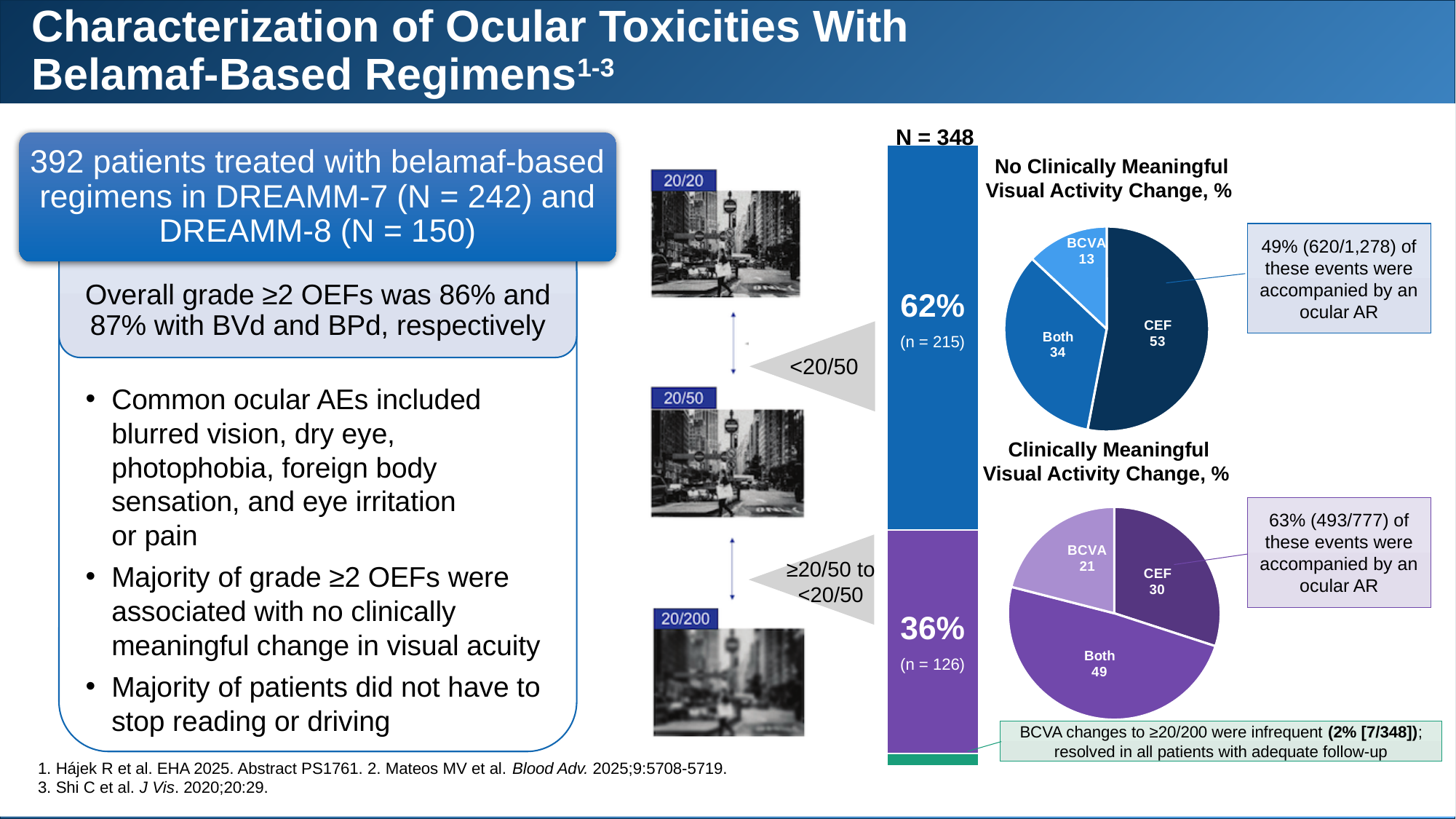
In the stacked bar on the slide, what percentage is shown for the top (blue) segment? 62% In the 'No Clinically Meaningful Visual Activity Change, %' pie chart, what is the difference between the CEF and BCVA values? 40 Is the value for Both larger in the 'Clinically Meaningful' pie chart or in the 'No Clinically Meaningful' pie chart? Clinically Meaningful In the stacked bar on the slide, what is the n value shown for the 36% segment? n = 126 In the 'No Clinically Meaningful Visual Activity Change, %' pie chart, what is the value for Both? 34 What total N is shown above the stacked bar? N = 348 In the 'No Clinically Meaningful Visual Activity Change, %' pie chart, which category has the smallest slice? BCVA How many slices does the 'Clinically Meaningful Visual Activity Change, %' pie chart have? 3 In the 'No Clinically Meaningful Visual Activity Change, %' pie chart, what is the value for CEF? 53 In the 'Clinically Meaningful Visual Activity Change, %' pie chart, which category has the largest slice? Both What kind of chart is used to show the CEF, Both and BCVA breakdown? Pie chart In the 'Clinically Meaningful Visual Activity Change, %' pie chart, what is the value for BCVA? 21